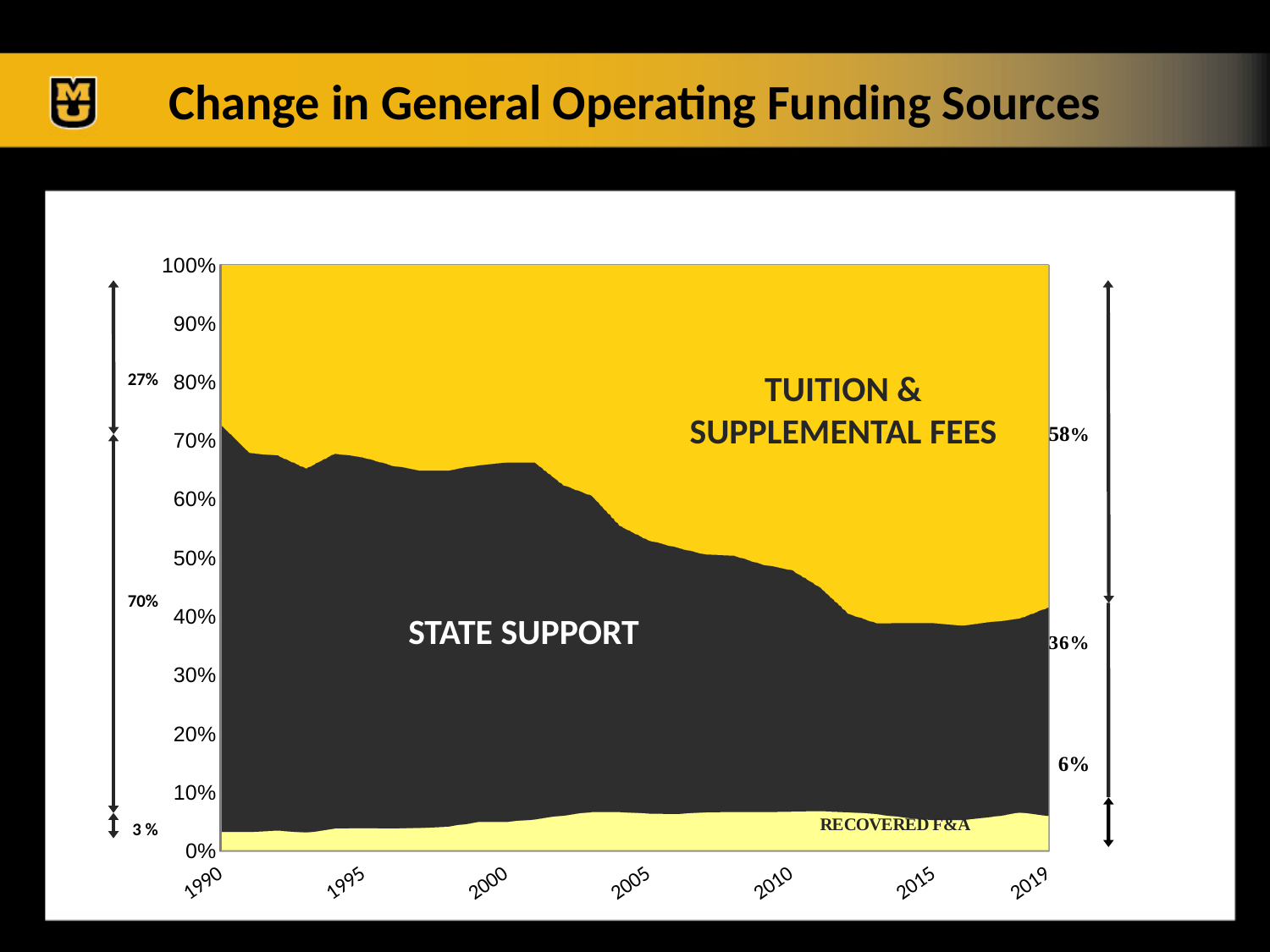
Does the state support share rise or fall from 1990 to 2019? Fall What share did recovered F&A contribute in 1990? 3% What is the title of the slide? Change in General Operating Funding Sources Which funding source was the largest in 2019? Tuition & supplemental fees What percentage of general operating funding came from tuition & supplemental fees in 2019? 58% What share did state support contribute in 2019? 36% What percentage of general operating funding came from state support in 1990? 70% Is the state support share in 2015 greater or less than 50%? less What kind of chart is shown on the slide? Stacked area chart By how many percentage points did the tuition & supplemental fees share increase from 1990 (27%) to 2019 (58%)? 31 percentage points What share did recovered F&A contribute in 2019? 6% Which funding source was the largest in 1990? State support